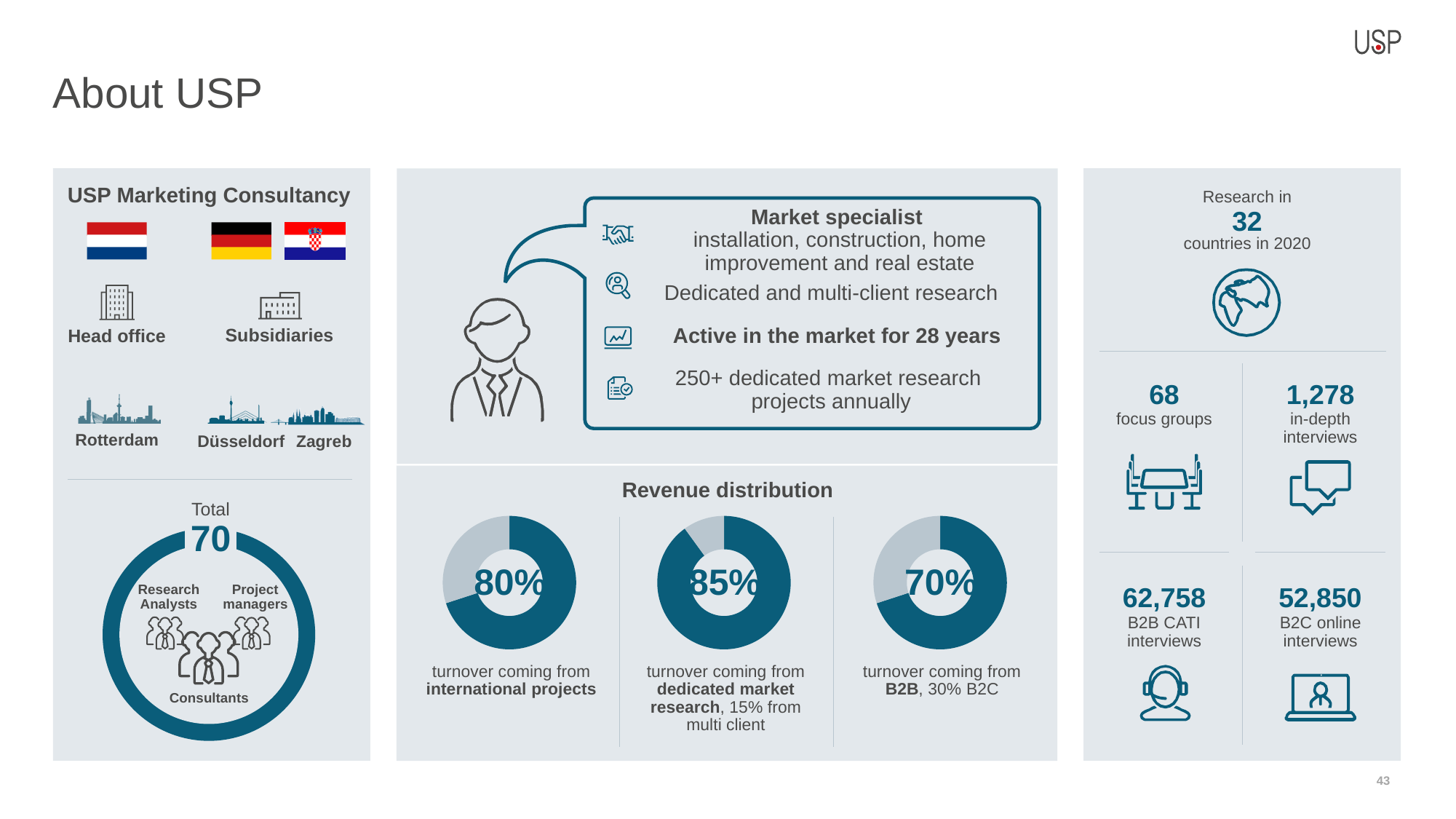
How many donut charts are shown in the Revenue distribution section? 3 In the Revenue distribution section, what share of turnover comes from B2B according to the right donut chart? 70% What is the title of the section containing the three donut charts? Revenue distribution What is the difference between the dedicated market research share (85%) and the B2B share (70%) in the Revenue distribution charts? 15% In the Revenue distribution section, what share of turnover comes from international projects according to the left donut chart? 80% What type of chart is used to show the Revenue distribution figures? Donut (pie) chart Is the share of turnover from international projects larger or smaller than the share from B2B? Larger Which of the three Revenue distribution donut charts shows the highest percentage? Dedicated market research (85%) In the Revenue distribution section, what share of turnover comes from multi client research? 15% Which of the three Revenue distribution donut charts shows the lowest percentage? B2B (70%) In the Revenue distribution section, what share of turnover comes from dedicated market research according to the middle donut chart? 85% In the Revenue distribution section, what share of turnover comes from B2C? 30%